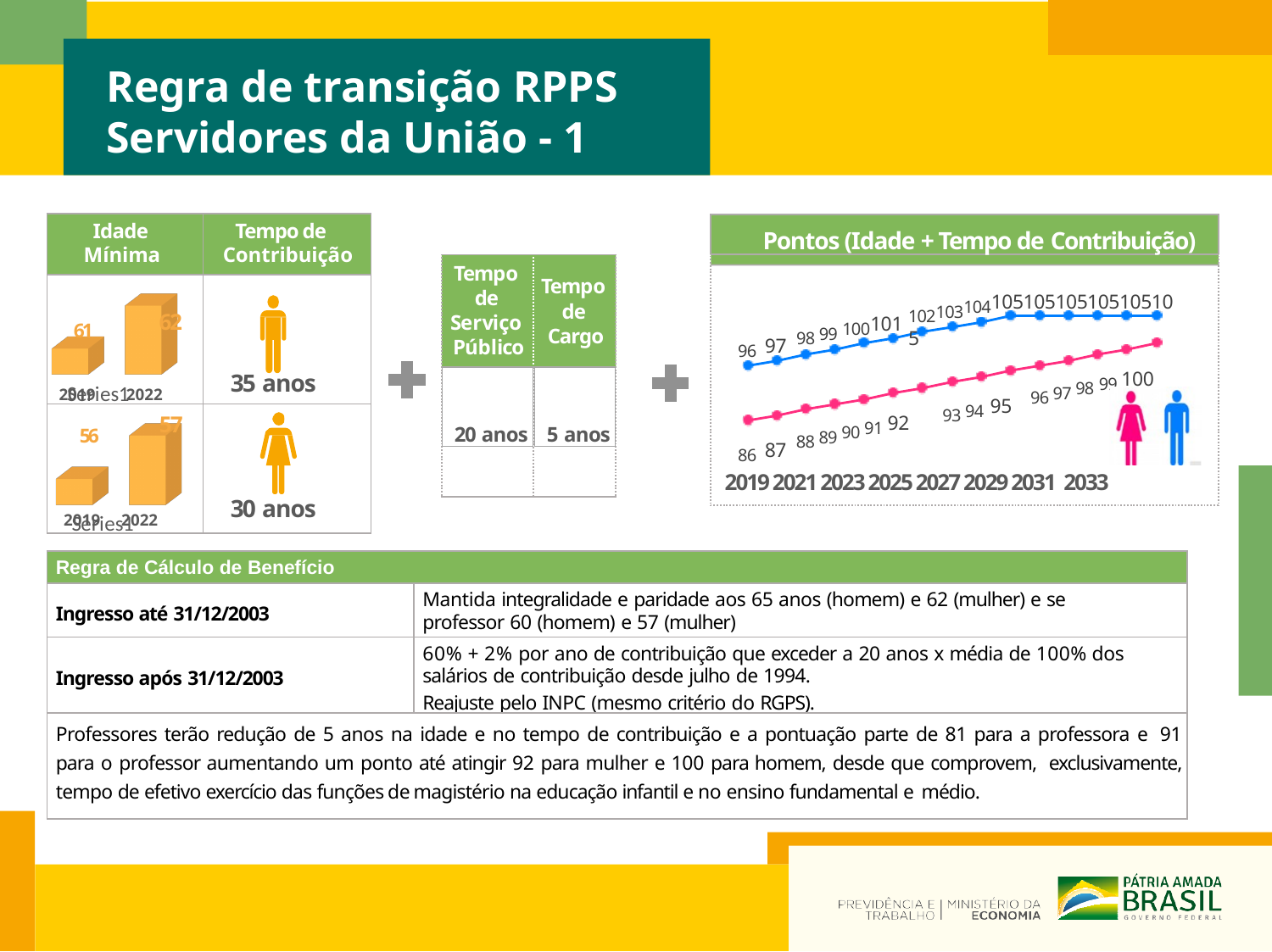
In the 'Pontos (Idade + Tempo de Contribuição)' line chart, what is the difference between the blue line and the pink line in 2019? 10 In the 'Pontos (Idade + Tempo de Contribuição)' line chart, what is the highest value reached by the blue (upper) line? 105 How many data series (lines) are plotted in the 'Pontos (Idade + Tempo de Contribuição)' chart? 2 What kind of chart is used in the 'Idade Mínima' column on the left of the slide? Bar chart In the 'Pontos (Idade + Tempo de Contribuição)' line chart, what is the highest value reached by the pink (lower) line? 100 In the 'Idade Mínima' bar chart for women (bottom left, with the female icon), what is the value for 2022? 57 In the 'Idade Mínima' bar chart for men (top left, with the male icon), what is the value for 2019? 61 In the 'Pontos (Idade + Tempo de Contribuição)' chart, do the values of the pink line rise or fall from 2019 to 2033? Rise In the 'Idade Mínima' bar charts on the left, which is larger: the 2022 value for men or the 2022 value for women? Men (62) What kind of chart is the 'Pontos (Idade + Tempo de Contribuição)' chart? Line chart In the 'Pontos (Idade + Tempo de Contribuição)' line chart, what is the value of the blue (upper) line in 2019? 96 In the 'Pontos (Idade + Tempo de Contribuição)' line chart, what is the value of the pink (lower) line in 2019? 86